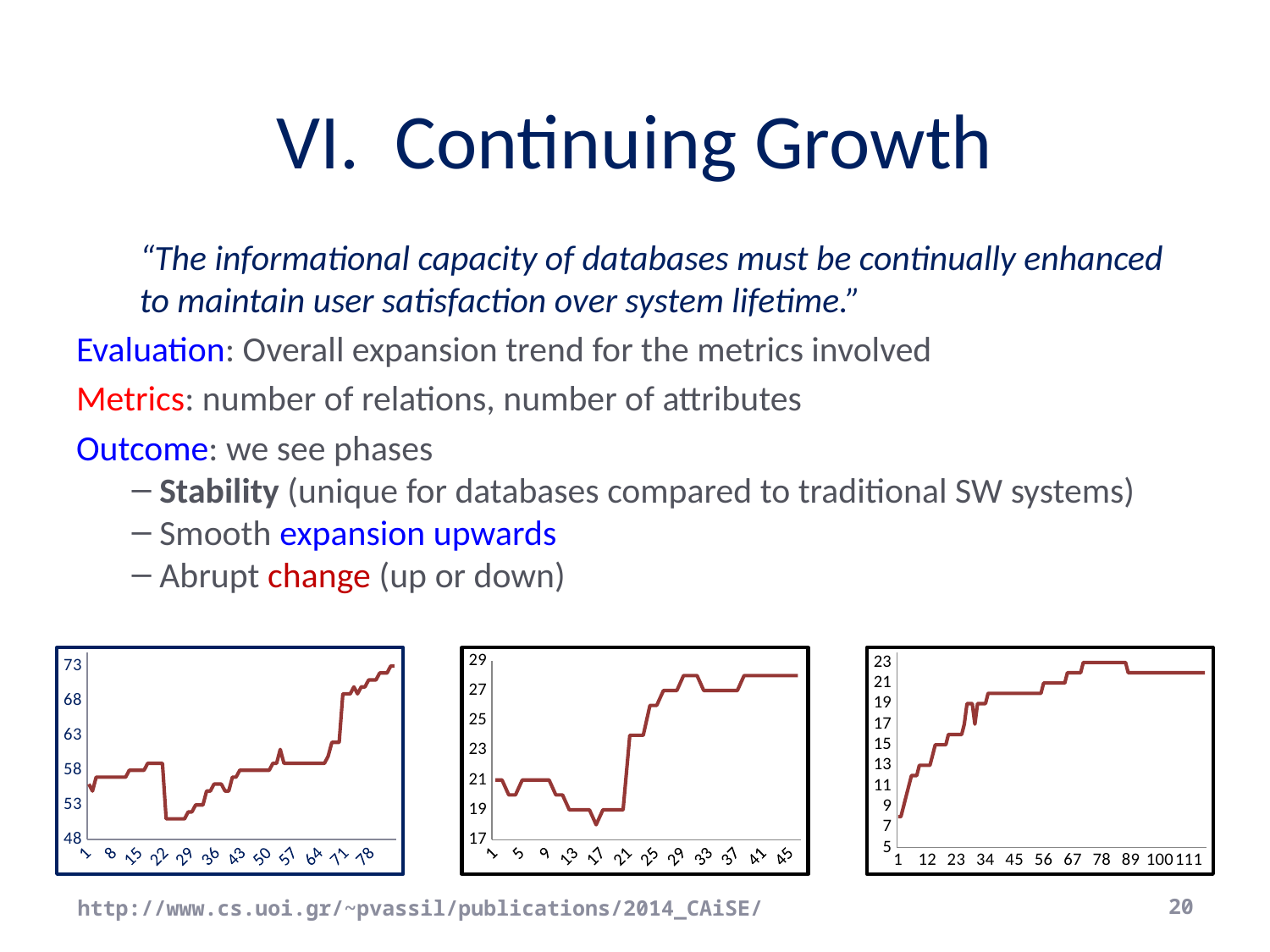
In the right chart, do the values overall rise or fall along the x axis? rise In the middle chart, is the lowest value (around x = 17) greater or less than 19? less How many charts are shown on the slide? 3 In the left chart, do the values overall rise or fall from left to right along the x axis? rise In the middle chart, is the value at the end of the series (around x = 45) greater or less than 27? greater What kind of chart is the left chart on the slide? line chart In the right chart, is the value at the end of the series (around x = 111) greater or less than 19? greater In the middle chart, do the values overall rise or fall from the start to the end of the x axis? rise What kind of chart is the right chart on the slide? line chart